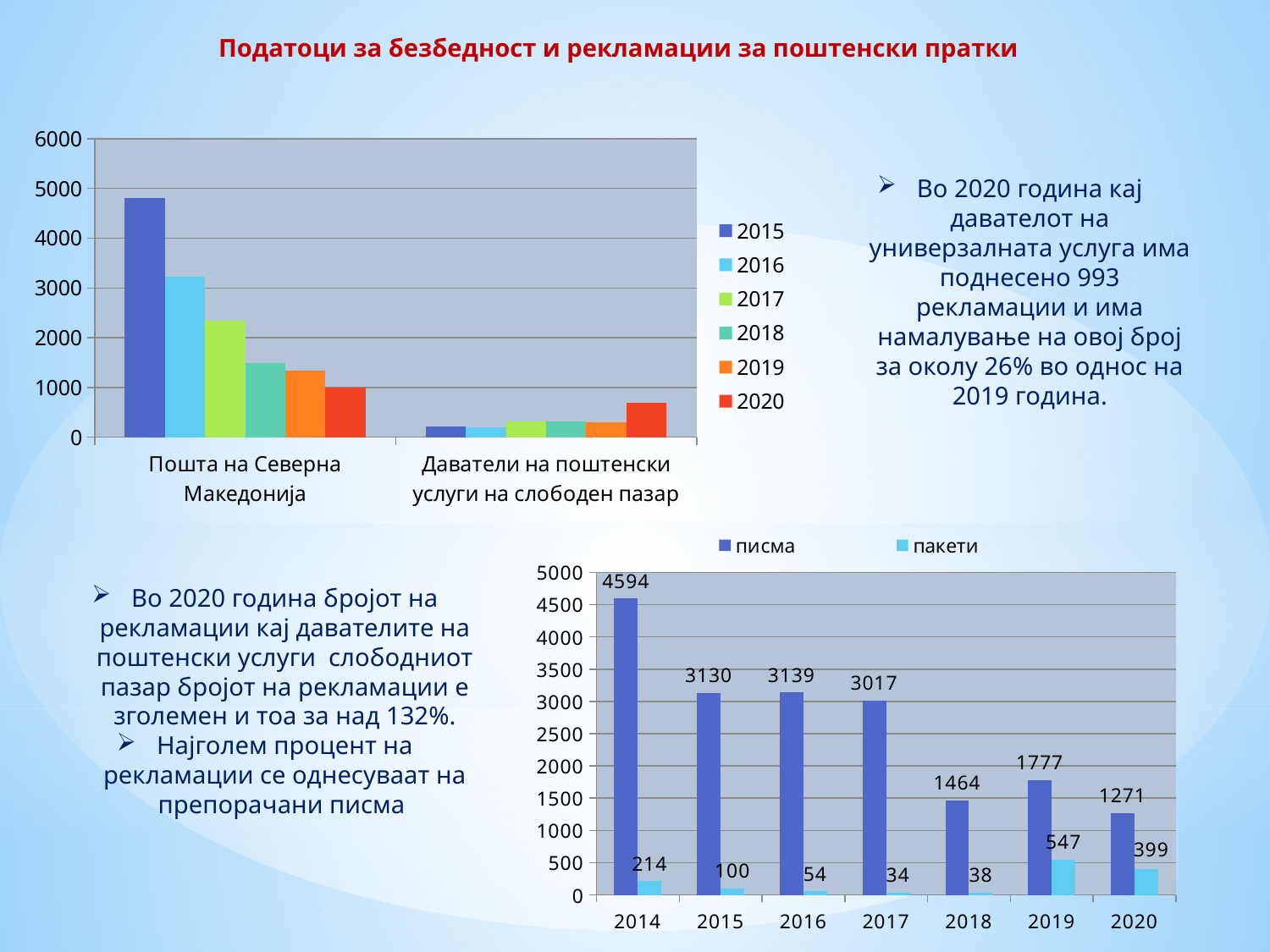
In the top-left chart, is the value for 2015 for Пошта на Северна Македонија greater or less than 4000? greater In the bottom-right chart, which is larger: пакети in 2019 or пакети in 2020? пакети in 2019 In the bottom-right chart, which year has the highest value for писма? 2014 In the top-left chart, which year has the highest value for Пошта на Северна Македонија? 2015 In the bottom-right chart, what is the value for писма in 2014? 4594 In the bottom-right chart, how many series does the legend list? 2 In the bottom-right chart, how many years are shown on the x axis? 7 In the bottom-right chart, what is the difference between писма in 2019 and писма in 2020? 506 In the top-left chart, how many series does the legend list? 6 In the bottom-right chart, which year has the lowest value for пакети? 2017 What kind of chart is the top-left chart? bar chart In the bottom-right chart, what is the value for пакети in 2019? 547